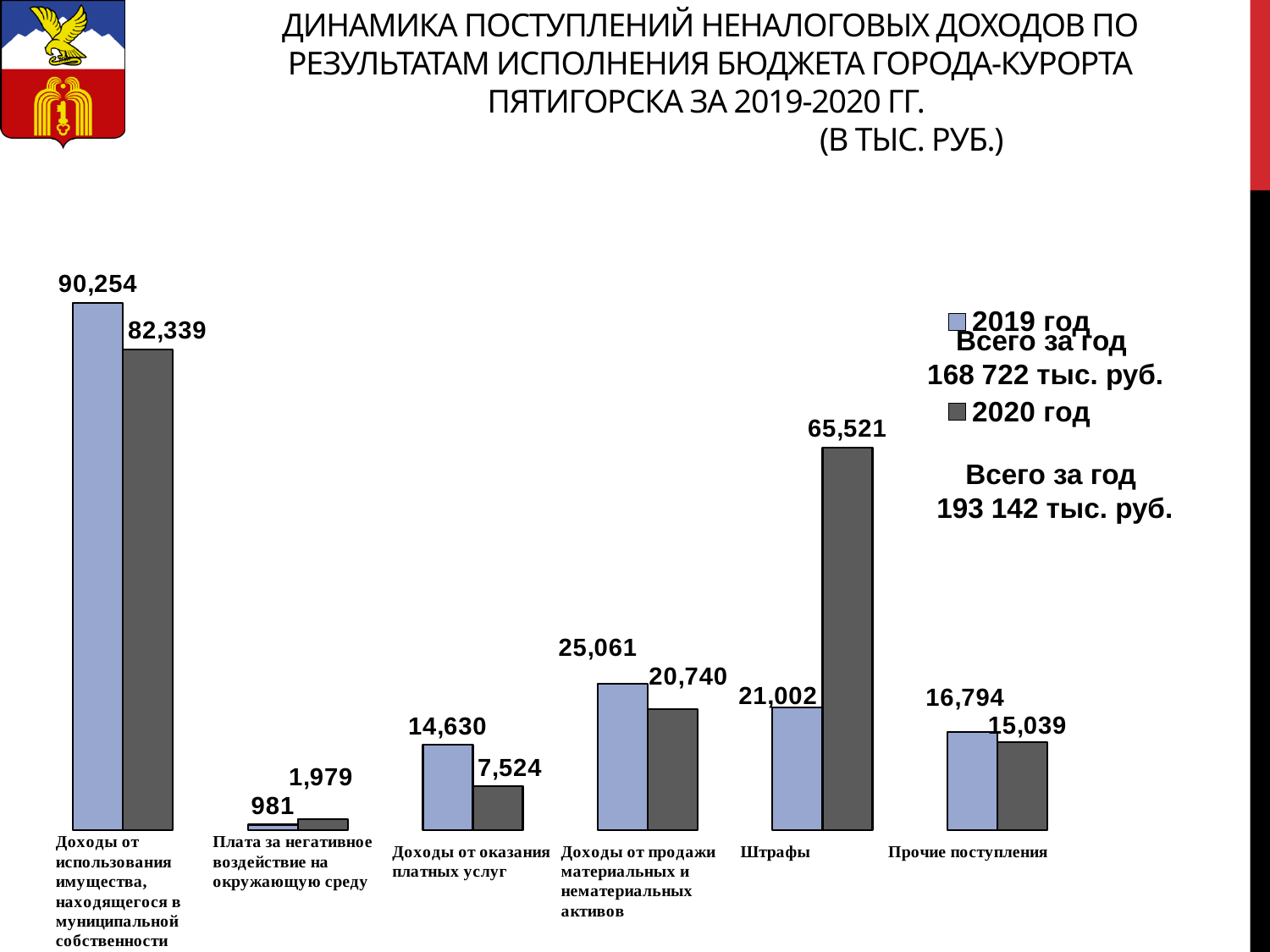
Which category has the lowest 2019 год value? Плата за негативное воздействие на окружающую среду What is the 2020 год value for Прочие поступления? 15,039 What total for the year is shown next to the 2020 год legend entry? 193 142 тыс. руб. What is the difference between the 2020 год and 2019 год values for Штрафы? 44,519 How many series does the legend list? 2 What is the 2019 год value for Штрафы? 21,002 Which category has the highest 2020 год value? Доходы от использования имущества, находящегося в муниципальной собственности Which is larger for Доходы от продажи материальных и нематериальных активов: the 2019 год value or the 2020 год value? 2019 год What kind of chart is shown on the slide? Bar chart What is the 2020 год value for Доходы от оказания платных услуг? 7,524 How many categories are shown on the x axis? 6 What is the 2019 год value for Плата за негативное воздействие на окружающую среду? 981